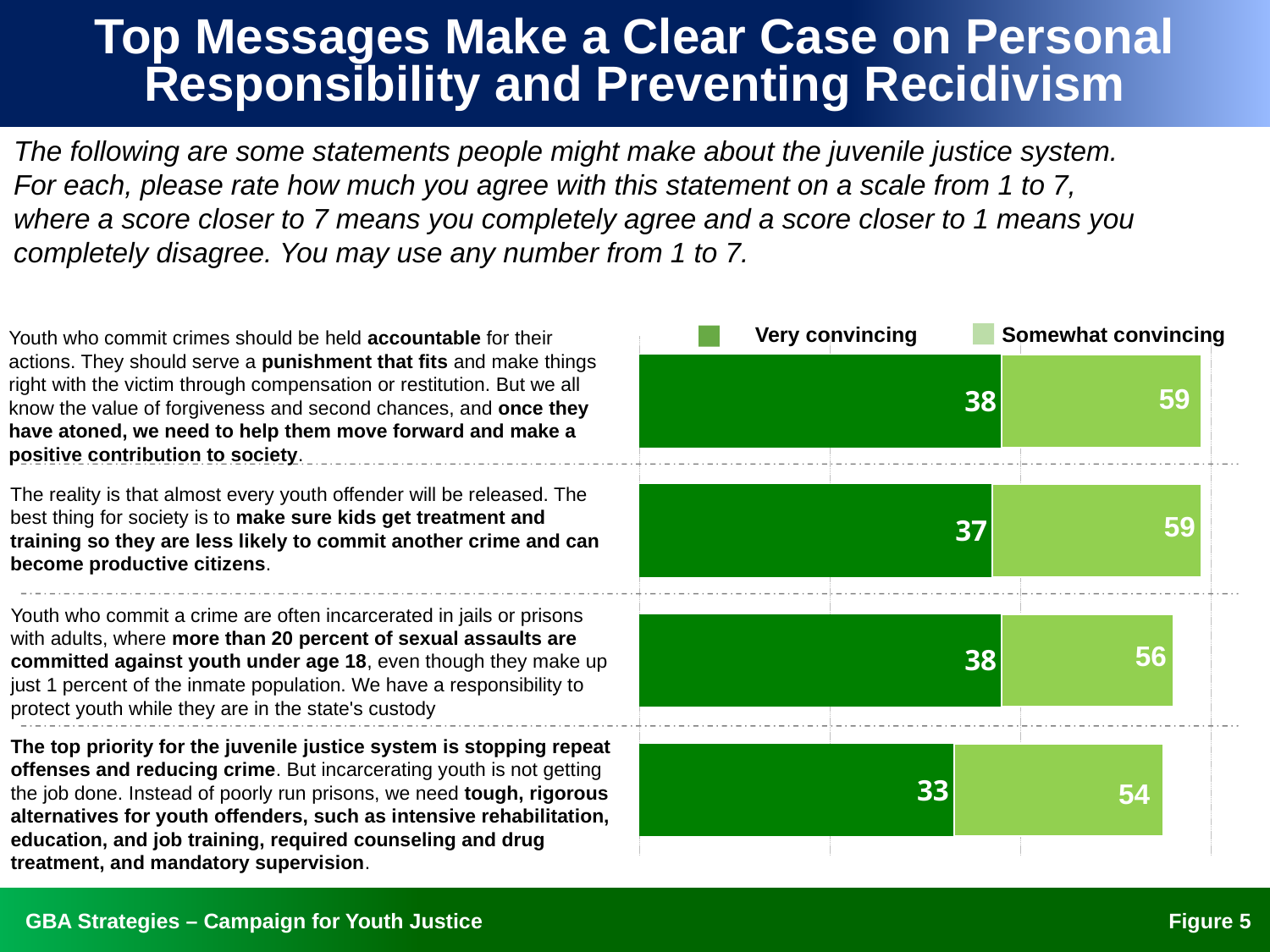
What is the 'Very convincing' value for the statement that youth who commit crimes should be held accountable? 38 What is the 'Very convincing' value for the statement that almost every youth offender will be released? 37 What is the 'Somewhat convincing' value for the statement about sexual assaults committed against youth under age 18? 56 What is the difference between the 'Somewhat convincing' values for the first statement (youth held accountable) and the last statement (top priority is stopping repeat offenses)? 5 Is the 'Very convincing' value larger for the statement about youth being held accountable or for the statement about the top priority being stopping repeat offenses? Youth being held accountable How many statements are plotted in the chart? 4 Which legend entry is shown in the darker green colour? Very convincing How many series does the legend list? 2 What is the 'Somewhat convincing' value for the statement that the top priority for the juvenile justice system is stopping repeat offenses? 54 Which statement has the lowest 'Very convincing' value? The top priority for the juvenile justice system is stopping repeat offenses and reducing crime Which statement has the lowest 'Somewhat convincing' value? The top priority for the juvenile justice system is stopping repeat offenses and reducing crime What kind of chart is shown on the slide? Bar chart